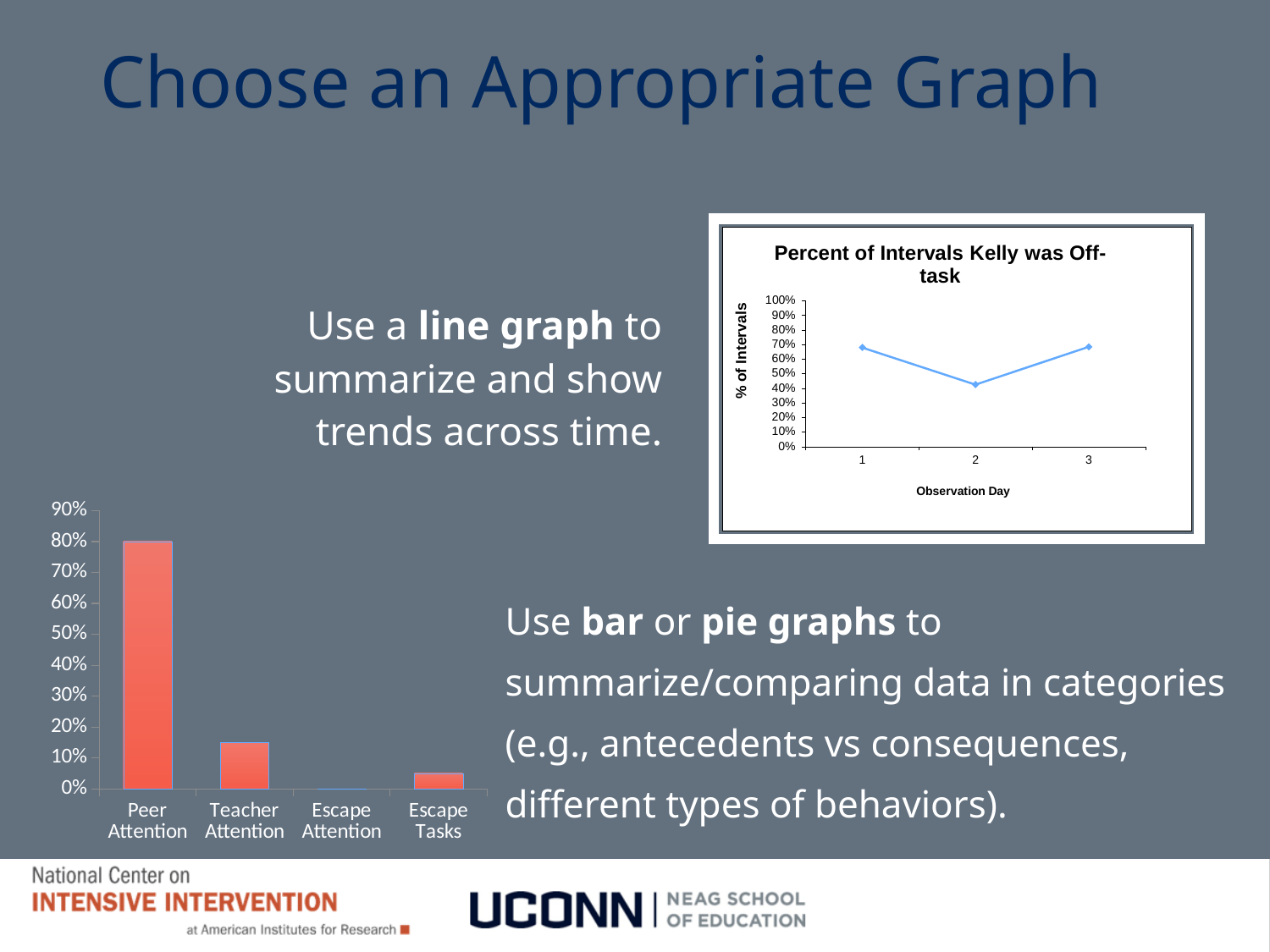
In the bar chart at the bottom left of the slide, which category has the highest value? Peer Attention In the chart titled 'Percent of Intervals Kelly was Off-task', is the value for observation day 2 greater or less than 50%? less In the bar chart at the bottom left of the slide, which category has the lowest value? Escape Attention In the chart titled 'Percent of Intervals Kelly was Off-task', how many observation days are plotted? 3 In the bar chart at the bottom left of the slide, is the value for Teacher Attention greater or less than 20%? less In the chart titled 'Percent of Intervals Kelly was Off-task', what is the label of the x axis? Observation Day In the chart titled 'Percent of Intervals Kelly was Off-task', which observation day has the lowest value? 2 In the bar chart at the bottom left of the slide, how many categories are shown? 4 In the bar chart at the bottom left of the slide, which is larger, Teacher Attention or Escape Tasks? Teacher Attention What type of chart is the chart at the bottom left of the slide? bar chart What type of chart is the chart titled 'Percent of Intervals Kelly was Off-task'? line chart In the chart titled 'Percent of Intervals Kelly was Off-task', is the value for observation day 1 greater or less than 60%? greater